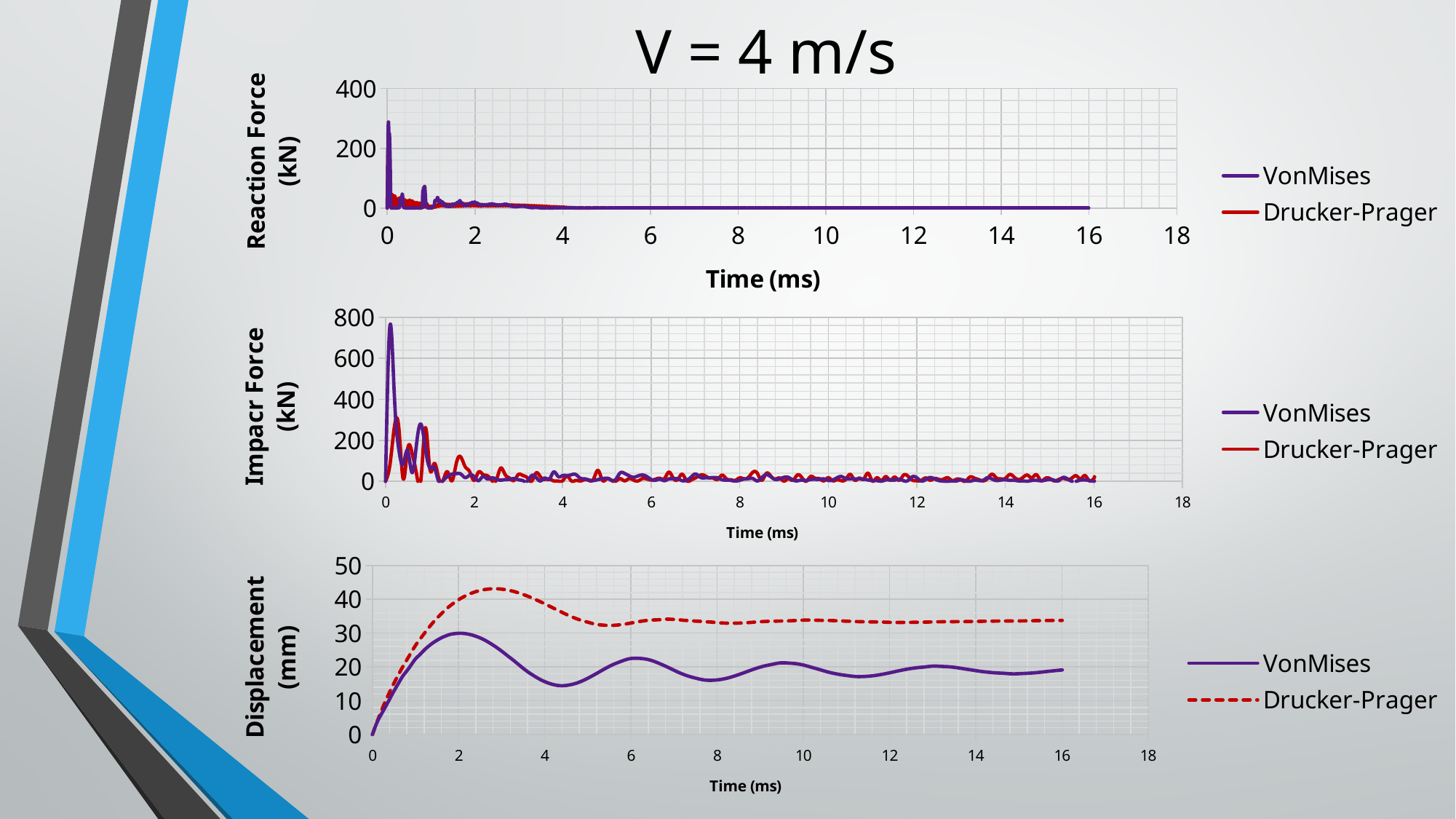
In the Impact Force chart, is the peak value of the VonMises series greater or less than 600? greater What is the x-axis label of the Displacement chart? Time (ms) In the Reaction Force chart, is the peak value of the VonMises series greater or less than 200? greater In the Displacement chart, which series has the larger value at 16 ms, VonMises or Drucker-Prager? Drucker-Prager In the Impact Force chart, which series reaches the higher peak, VonMises or Drucker-Prager? VonMises In the Displacement chart, is the peak value of the Drucker-Prager series greater or less than 40? greater How many series does the legend of the Displacement chart list? 2 In the Displacement chart, does the Drucker-Prager series rise or fall between 0 and 2 ms? rise What kind of chart is the Reaction Force chart at the top of the slide? line chart In the Displacement chart, which series is drawn with a dashed line? Drucker-Prager